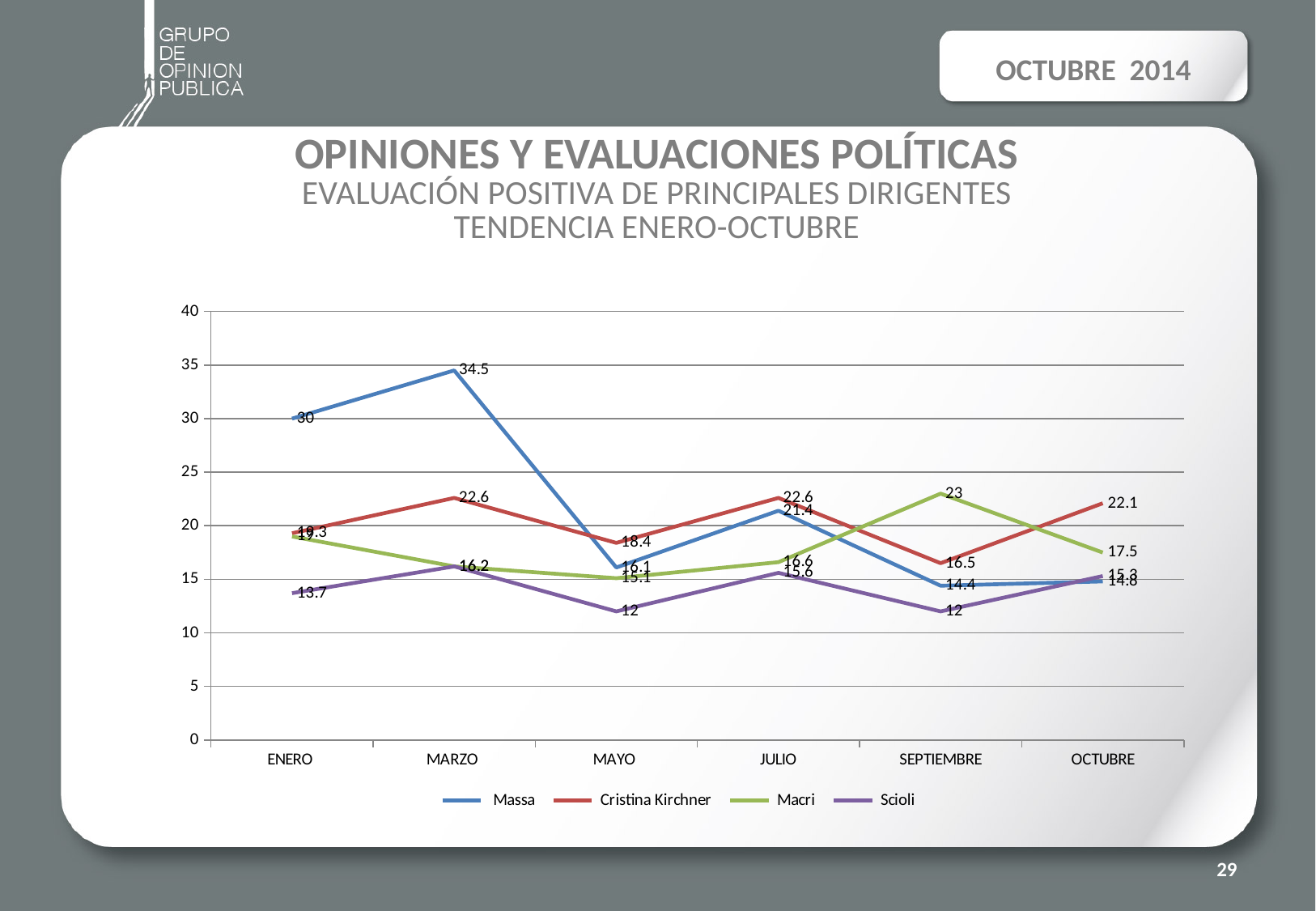
What is the value for Scioli in MAYO? 12 What is the value for Cristina Kirchner in OCTUBRE? 22.1 What is the value for Macri in SEPTIEMBRE? 23 What kind of chart is shown on the slide? line chart How many months are shown on the x axis? 6 What is the difference between Massa's value in MARZO and in MAYO? 18.4 Is the value for Massa in ENERO greater or less than 25? greater In which month does Massa have its lowest value? SEPTIEMBRE Which is higher in OCTUBRE, Cristina Kirchner or Macri? Cristina Kirchner What is the value for Massa in MARZO? 34.5 In which month does Massa reach its highest value? MARZO How many series does the legend list? 4